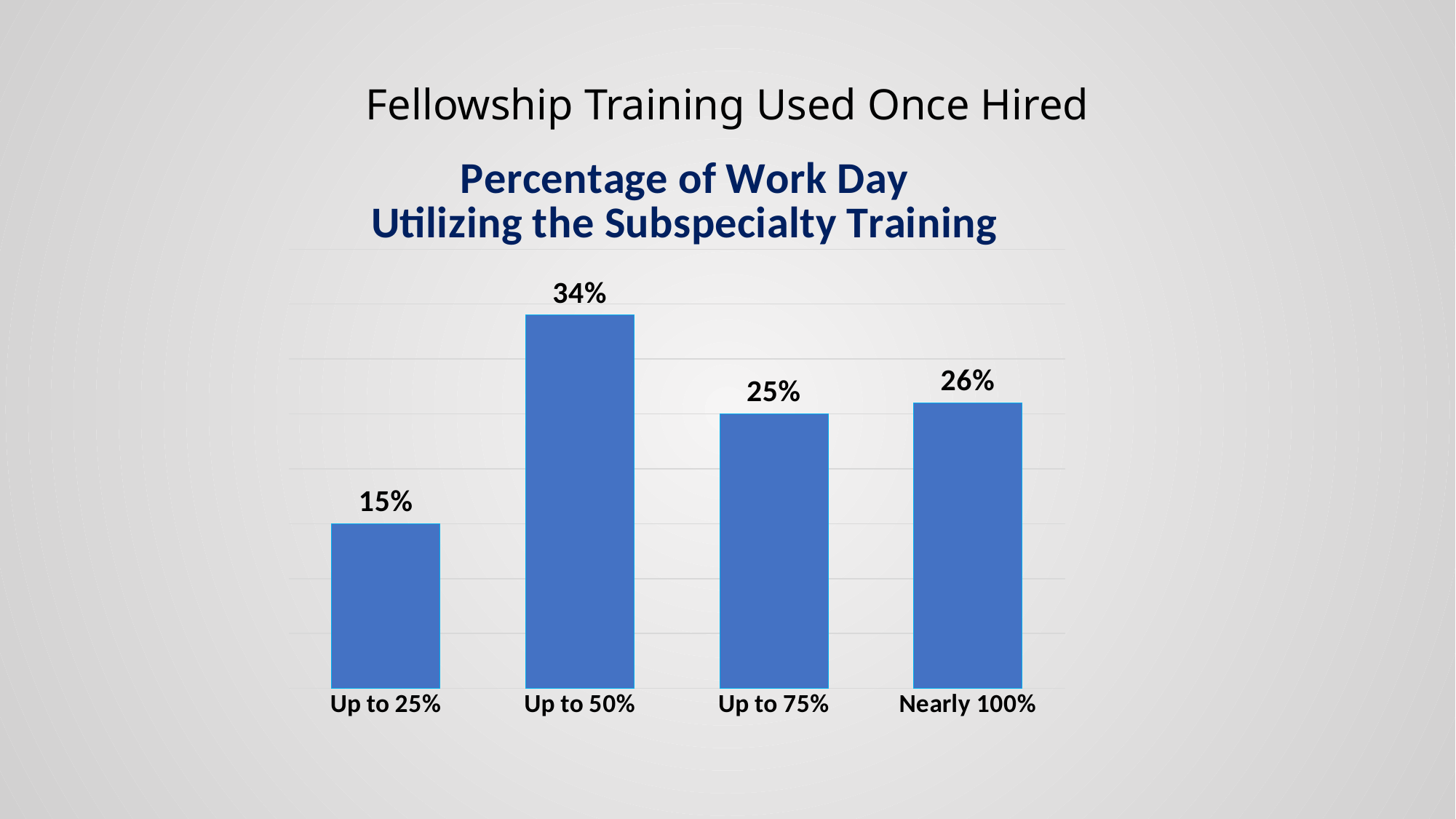
Which is larger, the value for "Up to 50%" or the value for "Nearly 100%"? Up to 50% What kind of chart is shown on the slide? Bar chart What is the value for "Up to 50%"? 34% What is the difference between the values for "Up to 50%" and "Up to 25%"? 19% What is the value for "Up to 75%"? 25% Which category has the highest value? Up to 50% What is the difference between the values for "Nearly 100%" and "Up to 75%"? 1% Which category has the lowest value? Up to 25% What is the value for "Nearly 100%"? 26% What is the value for "Up to 25%"? 15% How many categories are shown in the chart? 4 What is the title of the chart? Percentage of Work Day Utilizing the Subspecialty Training